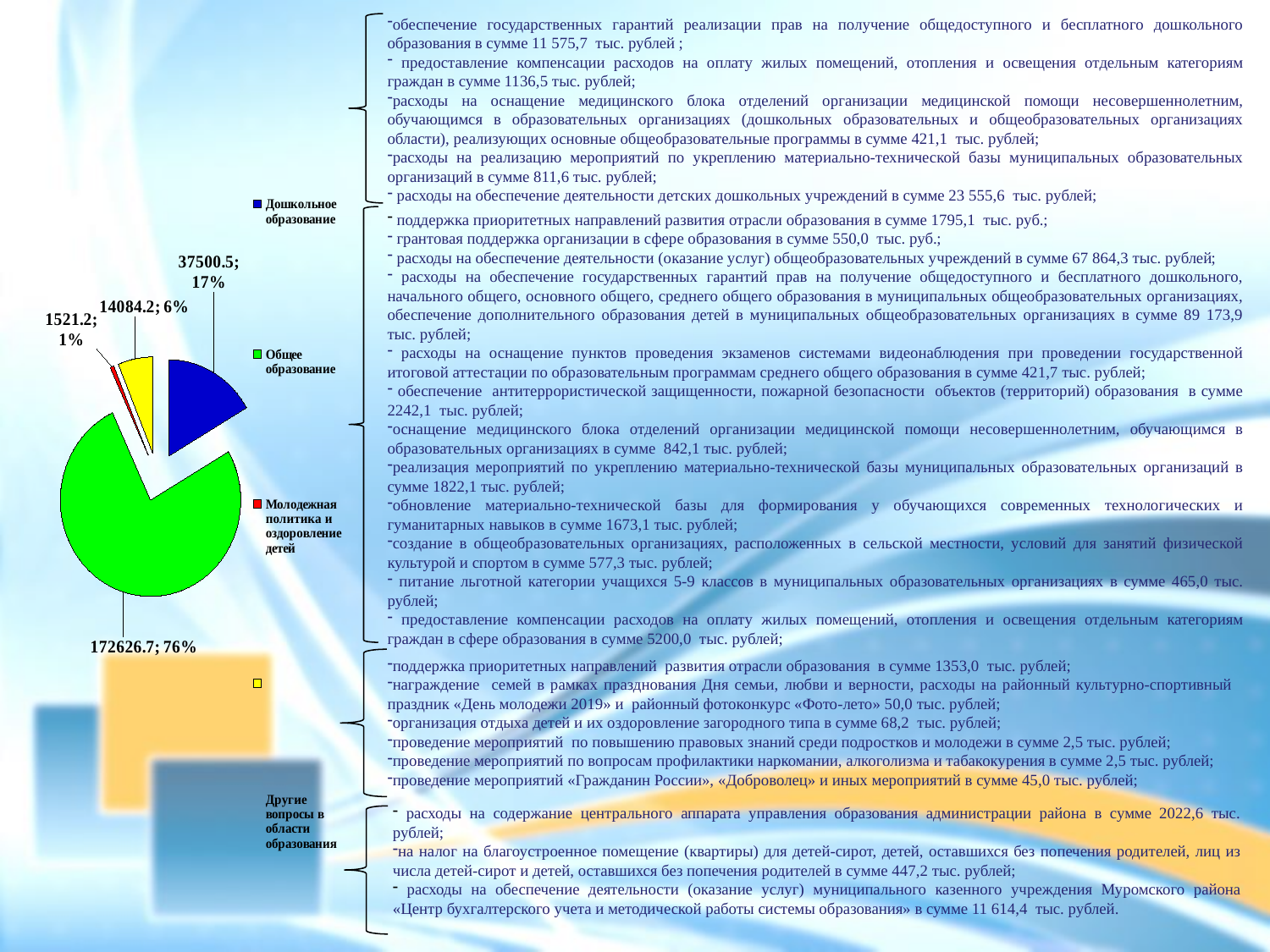
What value is shown for the slice "Общее образование"? 172626.7 Which slice of the pie chart is the smallest? Молодежная политика и оздоровление детей What share of the pie does "Общее образование" take? 76% What value is shown for the slice "Другие вопросы в области образования"? 14084.2 Which slice of the pie chart is the largest? Общее образование How many entries does the legend of the pie chart list? 4 What share of the pie does "Дошкольное образование" take? 17% What value is shown for the slice "Молодежная политика и оздоровление детей"? 1521.2 Which colour represents "Дошкольное образование" in the pie chart? Blue How many slices does the pie chart have? 4 What value is shown for the slice "Дошкольное образование"? 37500.5 What kind of chart is shown on the slide? Pie chart